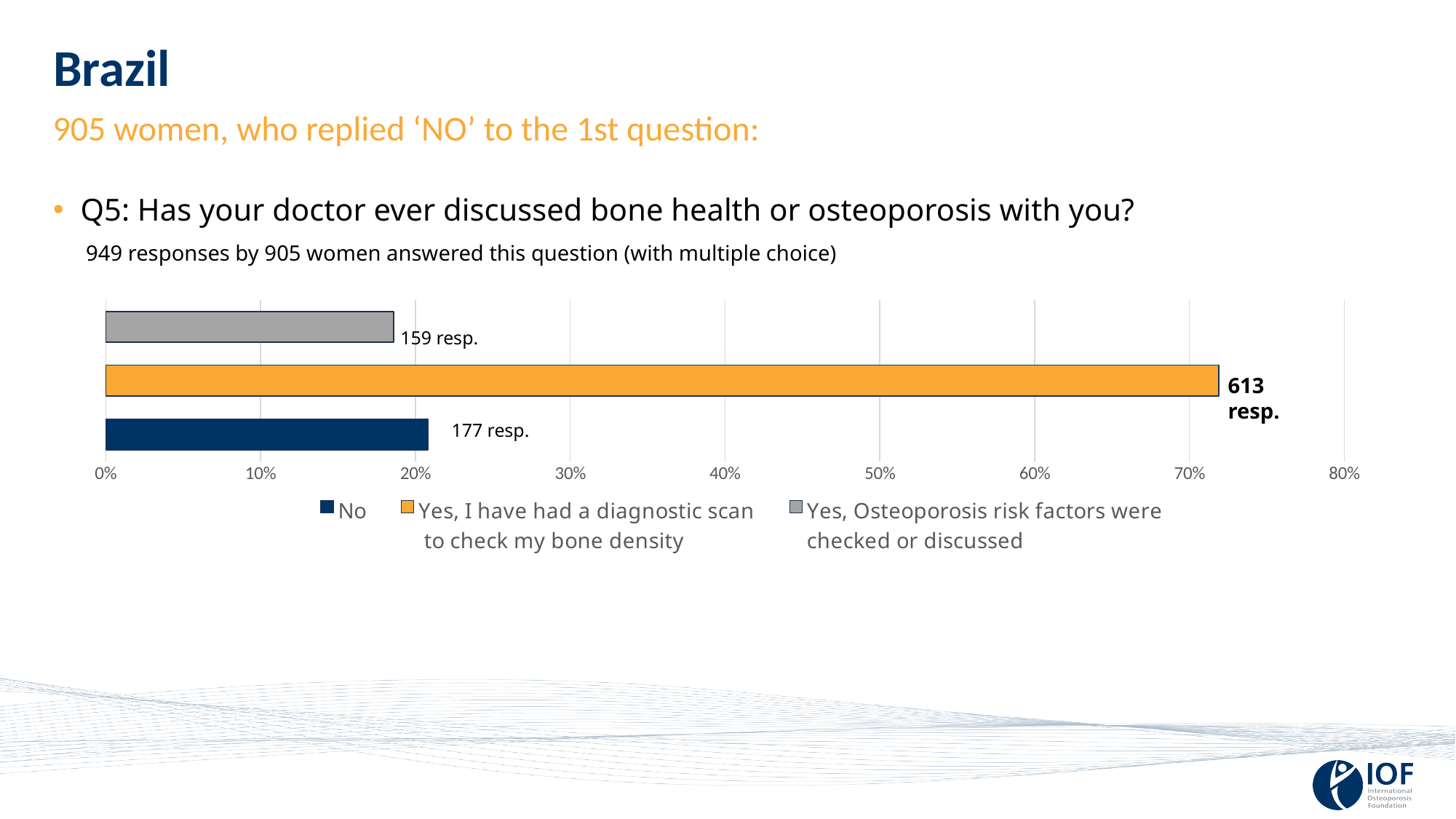
Is the bar for 'Yes, Osteoporosis risk factors were checked or discussed' greater or less than 20%? less Which response option has the lowest number of responses? Yes, Osteoporosis risk factors were checked or discussed Is the bar for 'Yes, I have had a diagnostic scan to check my bone density' greater or less than 70%? greater What kind of chart is shown on the slide? bar chart How many series does the legend list? 3 How many responses does the 'Yes, Osteoporosis risk factors were checked or discussed' bar show? 159 resp. What is the difference in responses between 'Yes, I have had a diagnostic scan to check my bone density' and 'No'? 436 Which response option has the highest number of responses? Yes, I have had a diagnostic scan to check my bone density Which has more responses: 'No' or 'Yes, Osteoporosis risk factors were checked or discussed'? No What is the difference in responses between 'No' and 'Yes, Osteoporosis risk factors were checked or discussed'? 18 How many responses does the 'Yes, I have had a diagnostic scan to check my bone density' bar show? 613 resp. How many responses does the 'No' bar show? 177 resp.